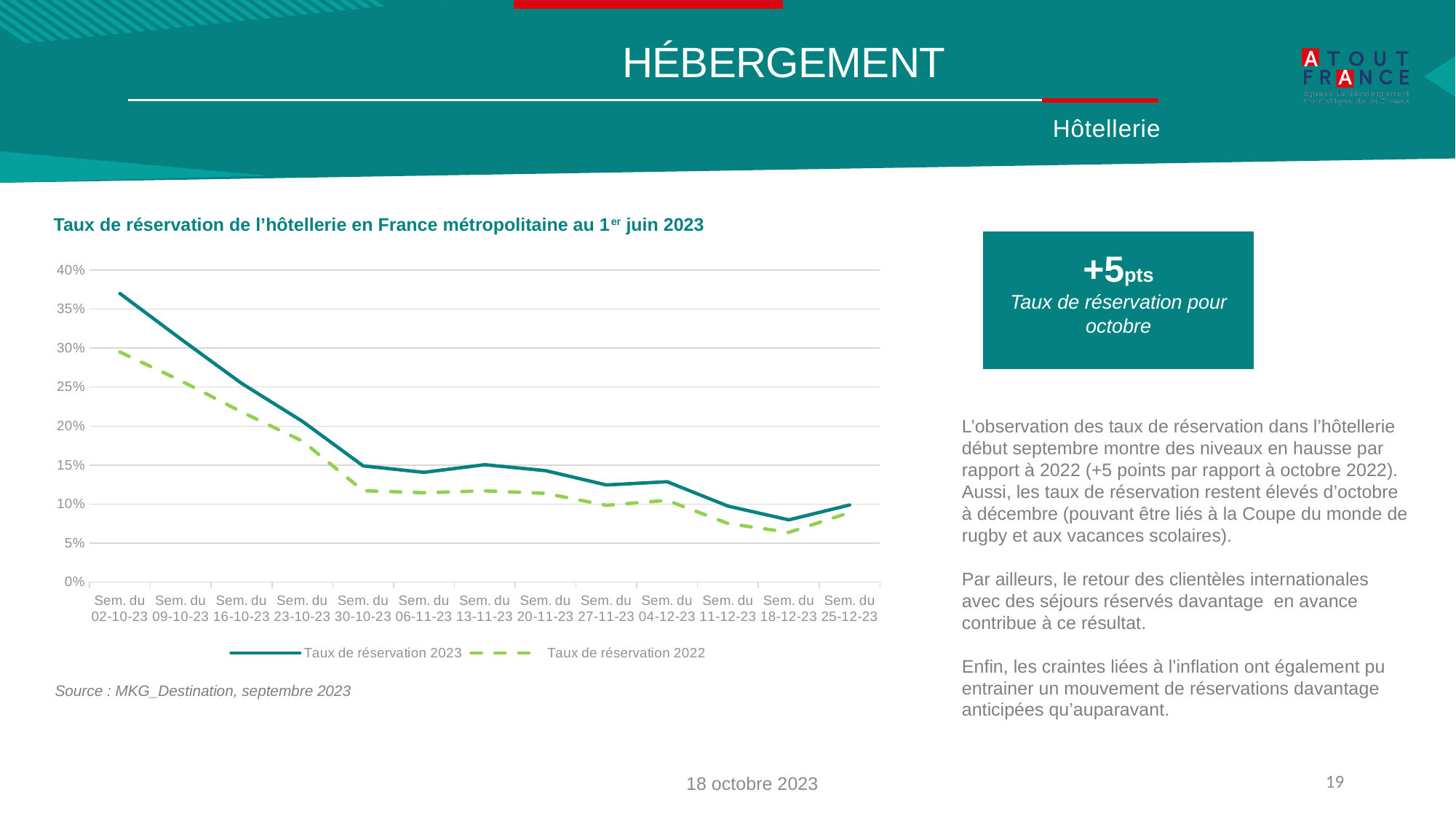
Is the value for 'Taux de réservation 2023' at Sem. du 18-12-23 greater or less than 10%? less What source is cited below the chart? MKG_Destination, septembre 2023 What kind of chart is shown on the slide? line chart For Sem. du 02-10-23, which series has the larger value: 'Taux de réservation 2023' or 'Taux de réservation 2022'? Taux de réservation 2023 Which week has the highest value for the 'Taux de réservation 2023' series? Sem. du 02-10-23 Is the value for 'Taux de réservation 2023' at Sem. du 02-10-23 greater or less than 35%? greater Which week has the lowest value for the 'Taux de réservation 2022' series? Sem. du 18-12-23 Which week has the lowest value for the 'Taux de réservation 2023' series? Sem. du 18-12-23 Is the value for 'Taux de réservation 2022' at Sem. du 02-10-23 greater or less than 25%? greater Do the values of the 'Taux de réservation 2023' series generally rise or fall from left to right along the x axis? fall How many weeks are plotted along the x axis of the chart? 13 How many series does the chart legend list? 2